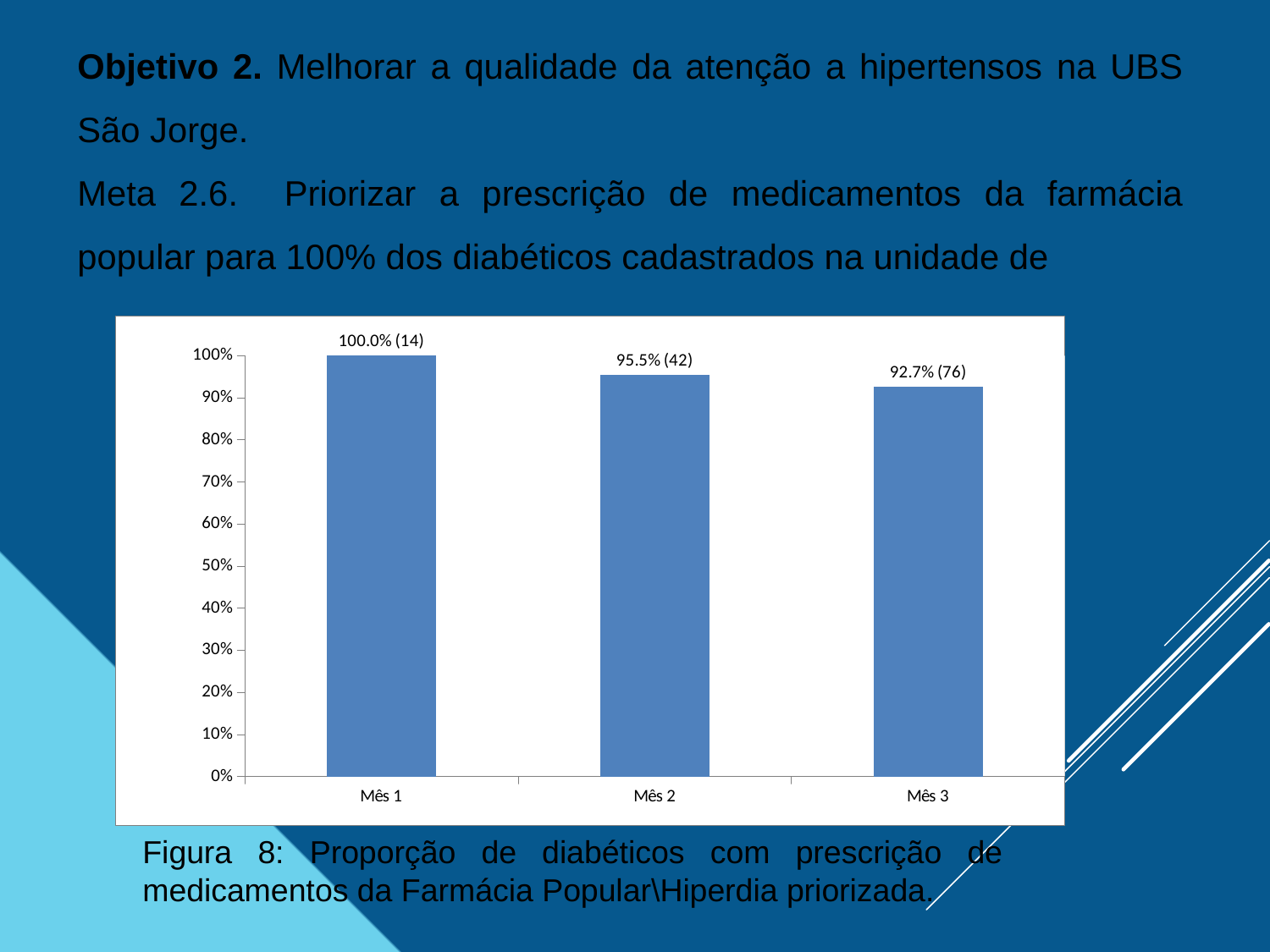
What is the value shown for Mês 1? 100.0% (14) What is the value shown for Mês 3? 92.7% (76) Is the value for Mês 3 greater or less than 90%? greater What is the value shown for Mês 2? 95.5% (42) Which is larger, the value for Mês 2 or the value for Mês 3? Mês 2 What is the difference in percentage points between Mês 1 and Mês 3? 7.3 Which month has the highest value? Mês 1 What is the difference in percentage points between Mês 2 and Mês 3? 2.8 How many months are shown on the x axis? 3 What kind of chart is shown on the slide? bar chart Which month has the lowest value? Mês 3 Do the values rise or fall from Mês 1 to Mês 3? fall